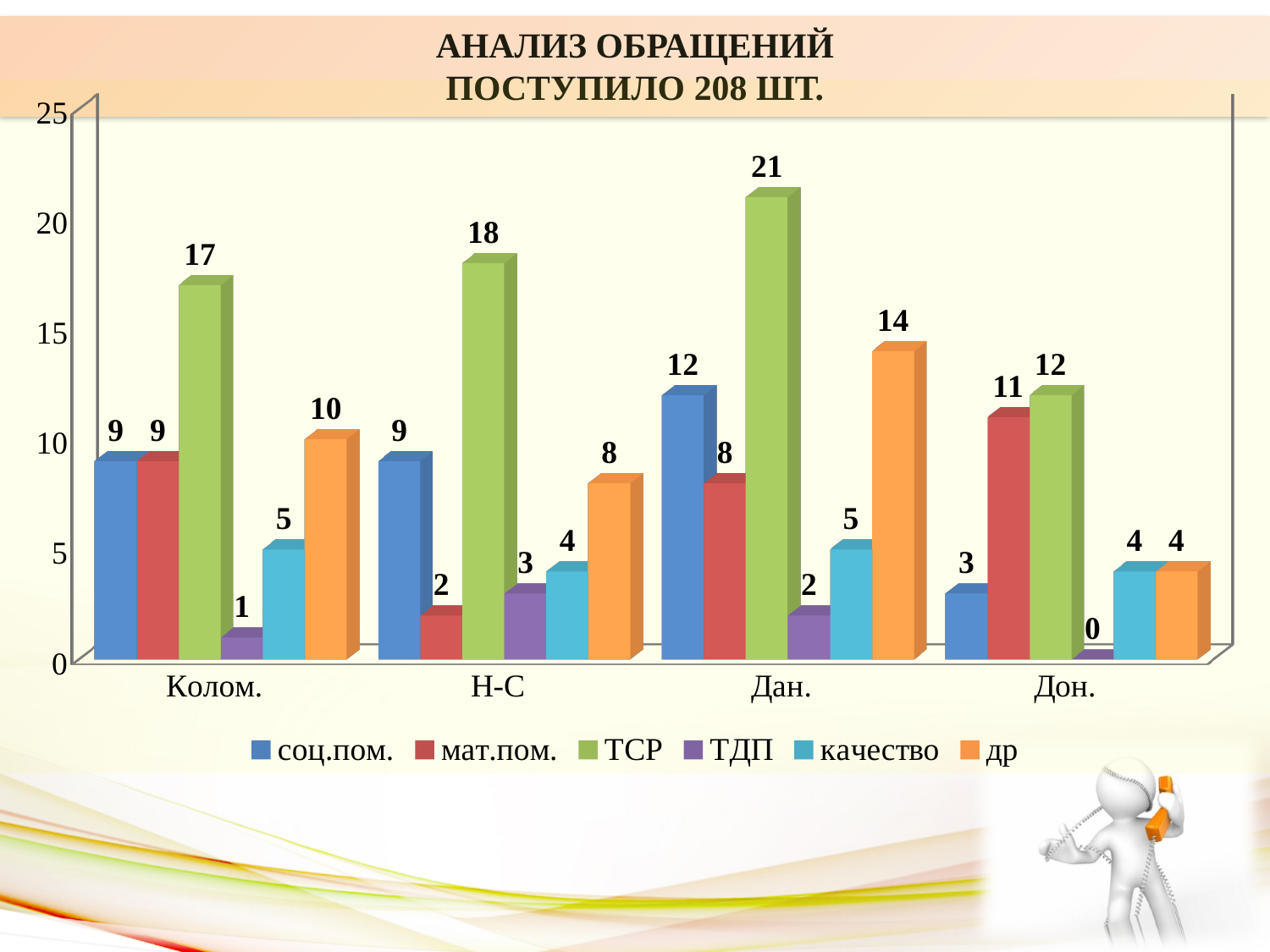
What kind of chart is shown on the slide? bar chart What is the value for ТСР in the Дан. category? 21 What is the difference between the ТСР values for Дан. and Колом.? 4 Which is larger: соц.пом. for Дан. or соц.пом. for Дон.? Дан. What is the total of all six series for the Н-С category? 44 How many series does the legend list? 6 How many categories are shown on the x axis? 4 What is the value for мат.пом. in the Дон. category? 11 Which category has the highest ТСР value? Дан. What is the value for др in the Колом. category? 10 Which category has the lowest ТДП value? Дон. What is the title of the chart? АНАЛИЗ ОБРАЩЕНИЙ ПОСТУПИЛО 208 ШТ.